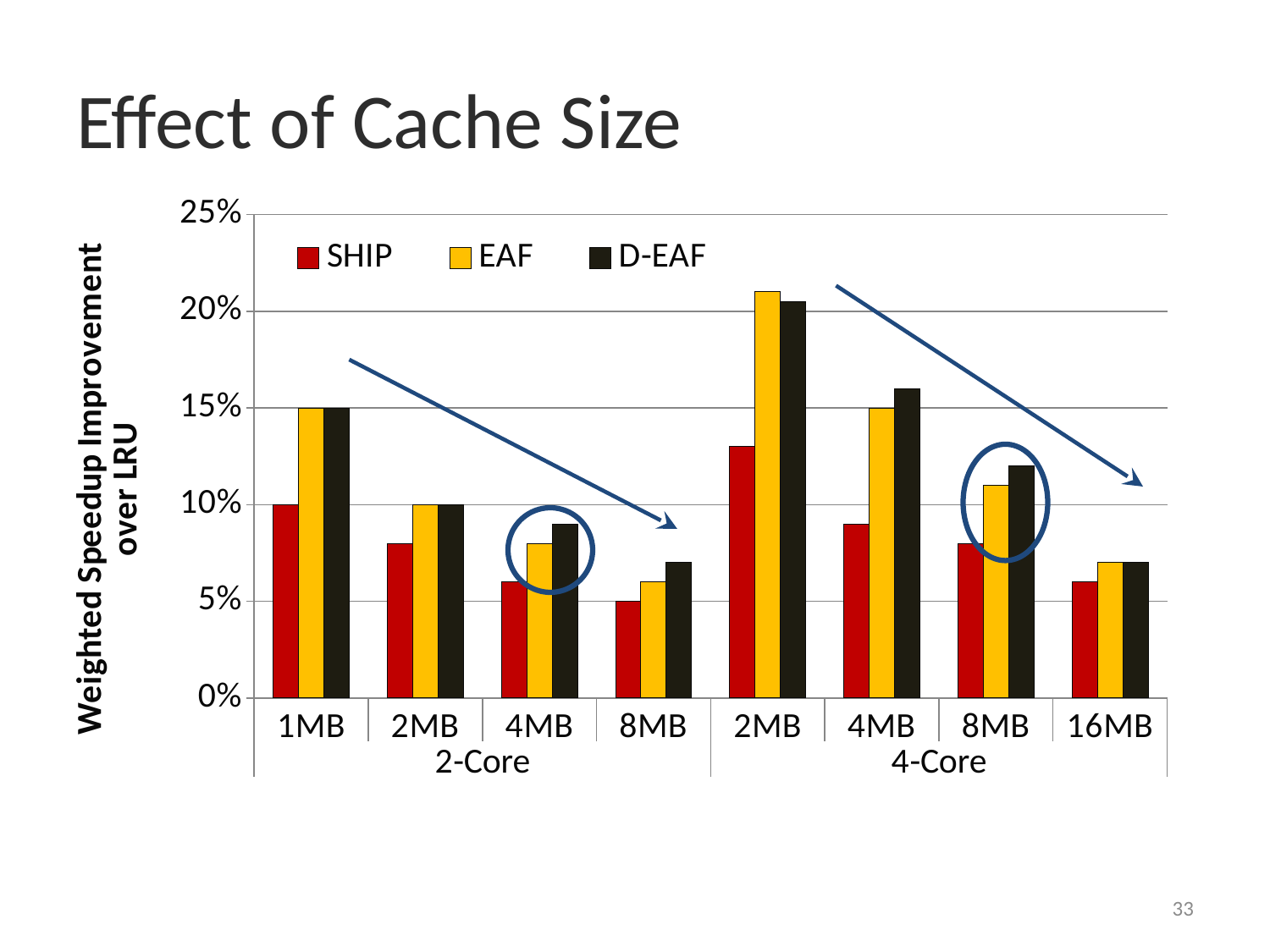
What is the EAF value for 1MB in the 2-Core group? 15% Is the EAF value for 2MB in the 4-Core group greater or less than 20%? greater How many series does the legend list? 3 Within the 4-Core group, at which cache size is the SHIP value highest? 2MB What is the y-axis title of the chart? Weighted Speedup Improvement over LRU What is the SHIP value for 1MB in the 2-Core group? 10% Is the D-EAF value for 16MB in the 4-Core group greater or less than 10%? less In the 2-Core group, do the values rise or fall as cache size increases from 1MB to 8MB? fall Within the 2-Core group, at which cache size is the SHIP value lowest? 8MB What kind of chart is shown on the slide? bar chart Which series is drawn in red? SHIP How many cache-size categories are shown along the x axis in total? 8